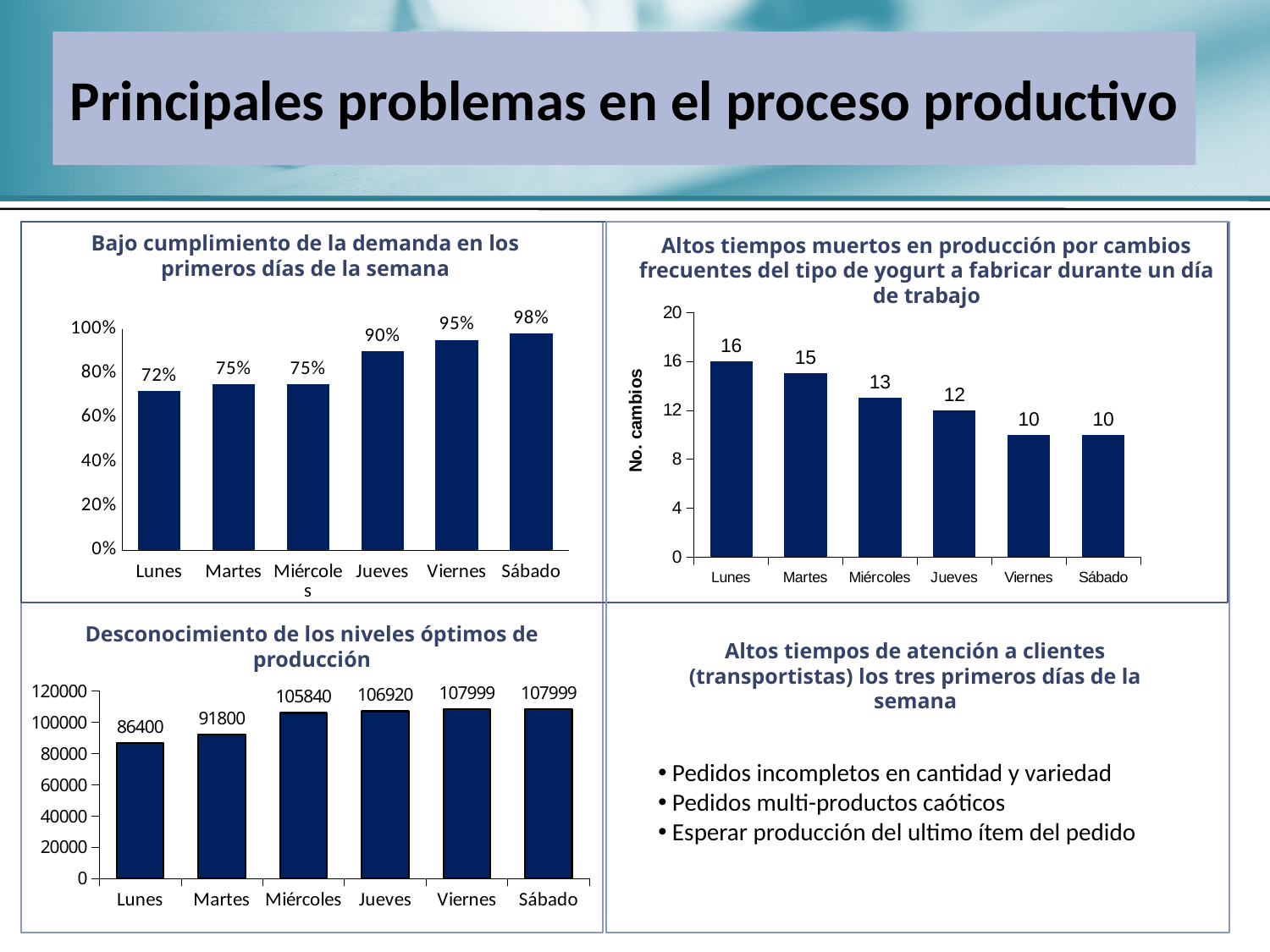
In the top-left chart 'Bajo cumplimiento de la demanda en los primeros días de la semana', what is the difference between the values for Sábado and Lunes? 26% In the bottom-left chart 'Desconocimiento de los niveles óptimos de producción', which day has the lowest value? Lunes What kind of chart is the bottom-left chart 'Desconocimiento de los niveles óptimos de producción'? bar chart In the top-right chart 'Altos tiempos muertos en producción por cambios frecuentes del tipo de yogurt a fabricar durante un día de trabajo', what is the value for Miércoles? 13 In the top-right chart 'Altos tiempos muertos en producción por cambios frecuentes del tipo de yogurt a fabricar durante un día de trabajo', which day has the highest number of changes? Lunes In the top-right chart 'Altos tiempos muertos en producción por cambios frecuentes del tipo de yogurt a fabricar durante un día de trabajo', what is the label of the vertical axis? No. cambios In the top-left chart 'Bajo cumplimiento de la demanda en los primeros días de la semana', what is the value for Lunes? 72% In the bottom-left chart 'Desconocimiento de los niveles óptimos de producción', what is the value for Martes? 91800 In the bottom-left chart 'Desconocimiento de los niveles óptimos de producción', which is larger, the value for Miércoles or the value for Jueves? Jueves In the top-left chart 'Bajo cumplimiento de la demanda en los primeros días de la semana', which day has the highest value? Sábado In the top-right chart 'Altos tiempos muertos en producción por cambios frecuentes del tipo de yogurt a fabricar durante un día de trabajo', how many days are shown on the x axis? 6 In the top-left chart 'Bajo cumplimiento de la demanda en los primeros días de la semana', do the values rise or fall from Lunes to Sábado? rise